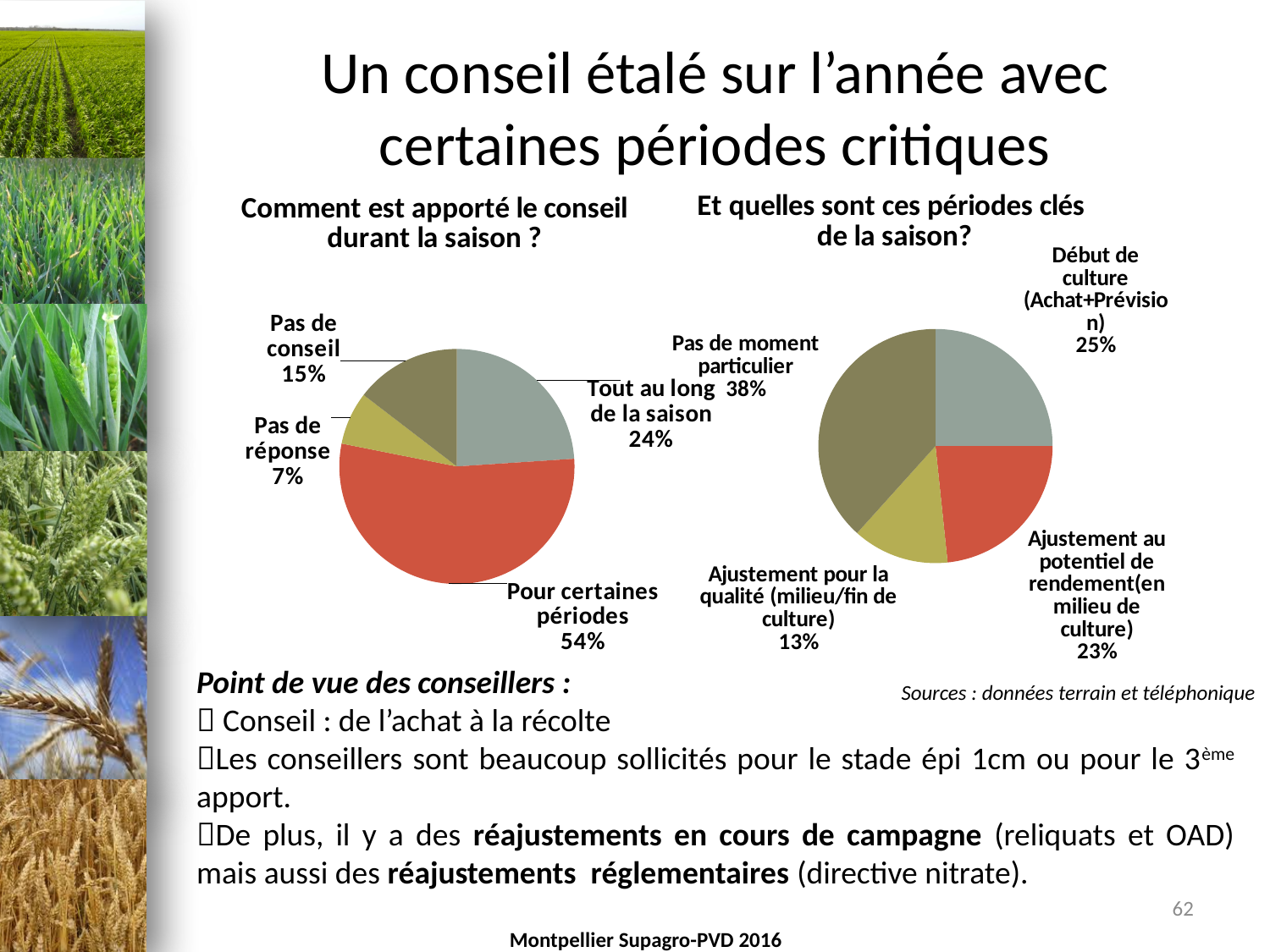
In the chart titled "Et quelles sont ces périodes clés de la saison?", which slice is the largest? Pas de moment particulier In the chart titled "Et quelles sont ces périodes clés de la saison?", which is larger: "Début de culture (Achat+Prévision)" or "Ajustement au potentiel de rendement (en milieu de culture)"? Début de culture (Achat+Prévision) In the chart titled "Comment est apporté le conseil durant la saison ?", which slice is the smallest? Pas de réponse What type of chart is the chart titled "Et quelles sont ces périodes clés de la saison?"? Pie chart In the chart titled "Comment est apporté le conseil durant la saison ?", what share is "Pour certaines périodes"? 54% In the chart titled "Et quelles sont ces périodes clés de la saison?", what share is "Pas de moment particulier"? 38% In the chart titled "Et quelles sont ces périodes clés de la saison?", what share is "Ajustement pour la qualité (milieu/fin de culture)"? 13% In the chart titled "Comment est apporté le conseil durant la saison ?", how many slices are there? 4 In the chart titled "Comment est apporté le conseil durant la saison ?", which slice is the largest? Pour certaines périodes In the chart titled "Comment est apporté le conseil durant la saison ?", what is the difference between "Pas de conseil" and "Pas de réponse"? 8%